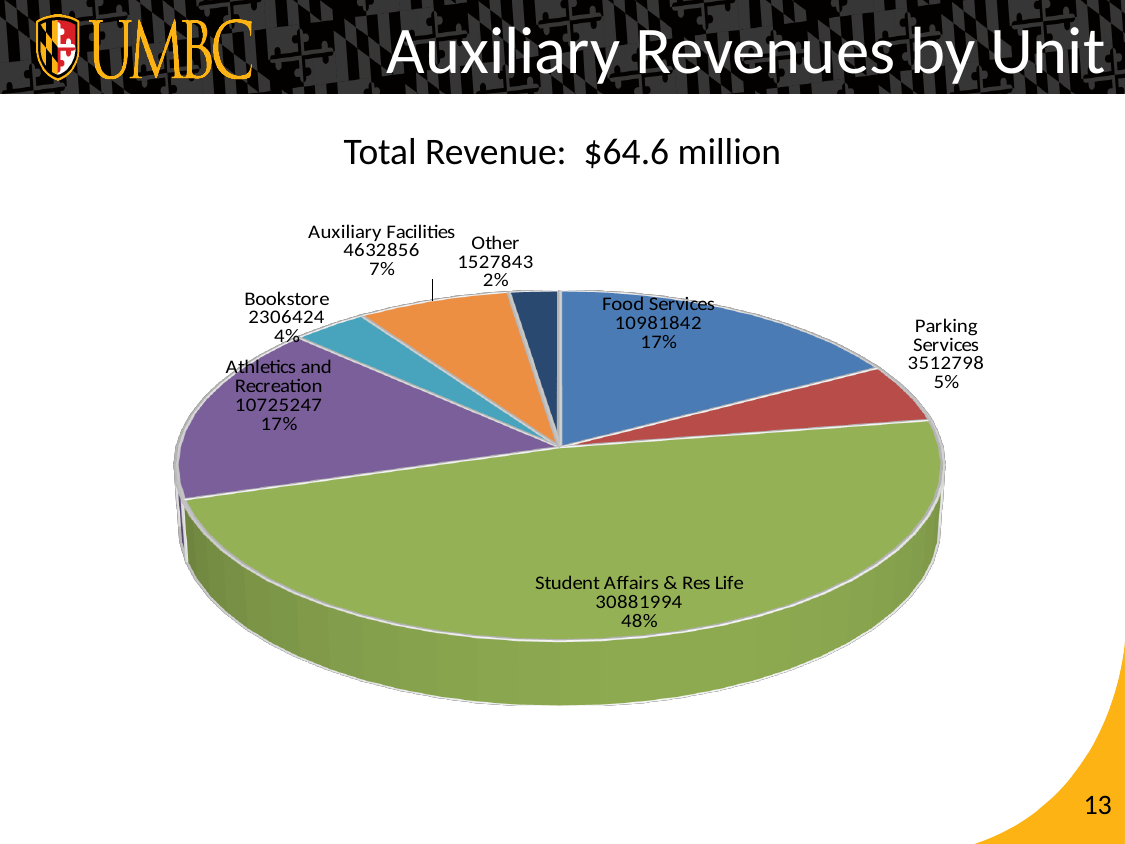
What is the difference between the value for Auxiliary Facilities and the value for Bookstore? 2326432 What kind of chart is shown on the slide? Pie chart What is the value for Student Affairs & Res Life? 30881994 What share of the pie does Auxiliary Facilities represent? 7% How many units (slices) are shown in the pie chart? 7 What total revenue is stated above the chart? $64.6 million What is the value for Parking Services? 3512798 Which unit has the smallest slice of the pie? Other Which is larger, the value for Food Services or the value for Athletics and Recreation? Food Services Which unit has the largest slice of the pie? Student Affairs & Res Life What share of the pie does Bookstore represent? 4% What is the value for Food Services? 10981842